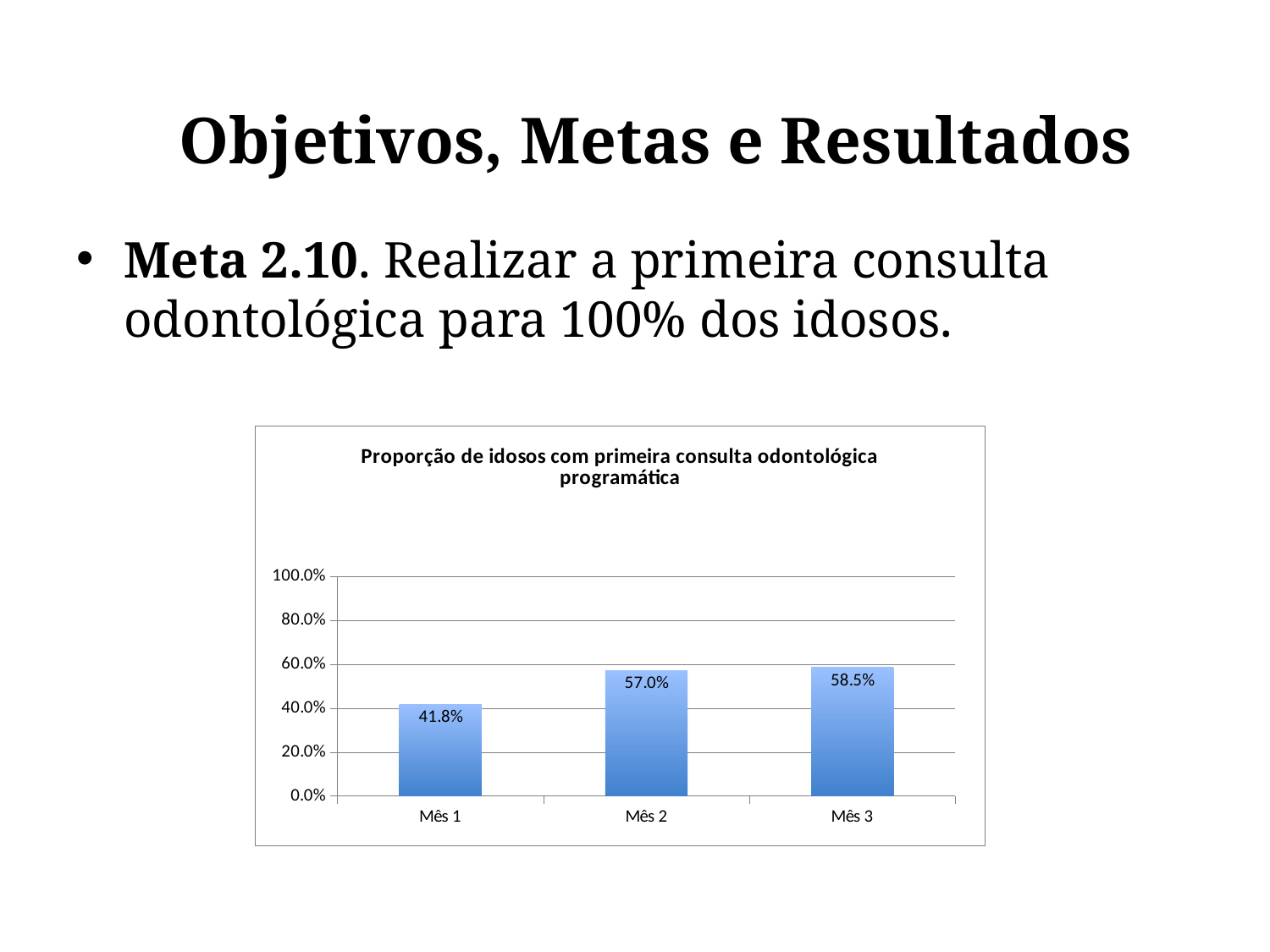
Do the values rise or fall from Mês 1 to Mês 3? rise What is the difference between the values for Mês 2 and Mês 1? 15.2% What is the value for Mês 2? 57.0% Which month has the highest value? Mês 3 How many months are shown on the x axis? 3 What kind of chart is shown on the slide? bar chart What is the difference between the values for Mês 3 and Mês 2? 1.5% Is the value for Mês 1 greater or less than 60.0%? less Which month has the lowest value? Mês 1 What is the value for Mês 1? 41.8% Which is larger, the value for Mês 1 or the value for Mês 2? Mês 2 What is the value for Mês 3? 58.5%